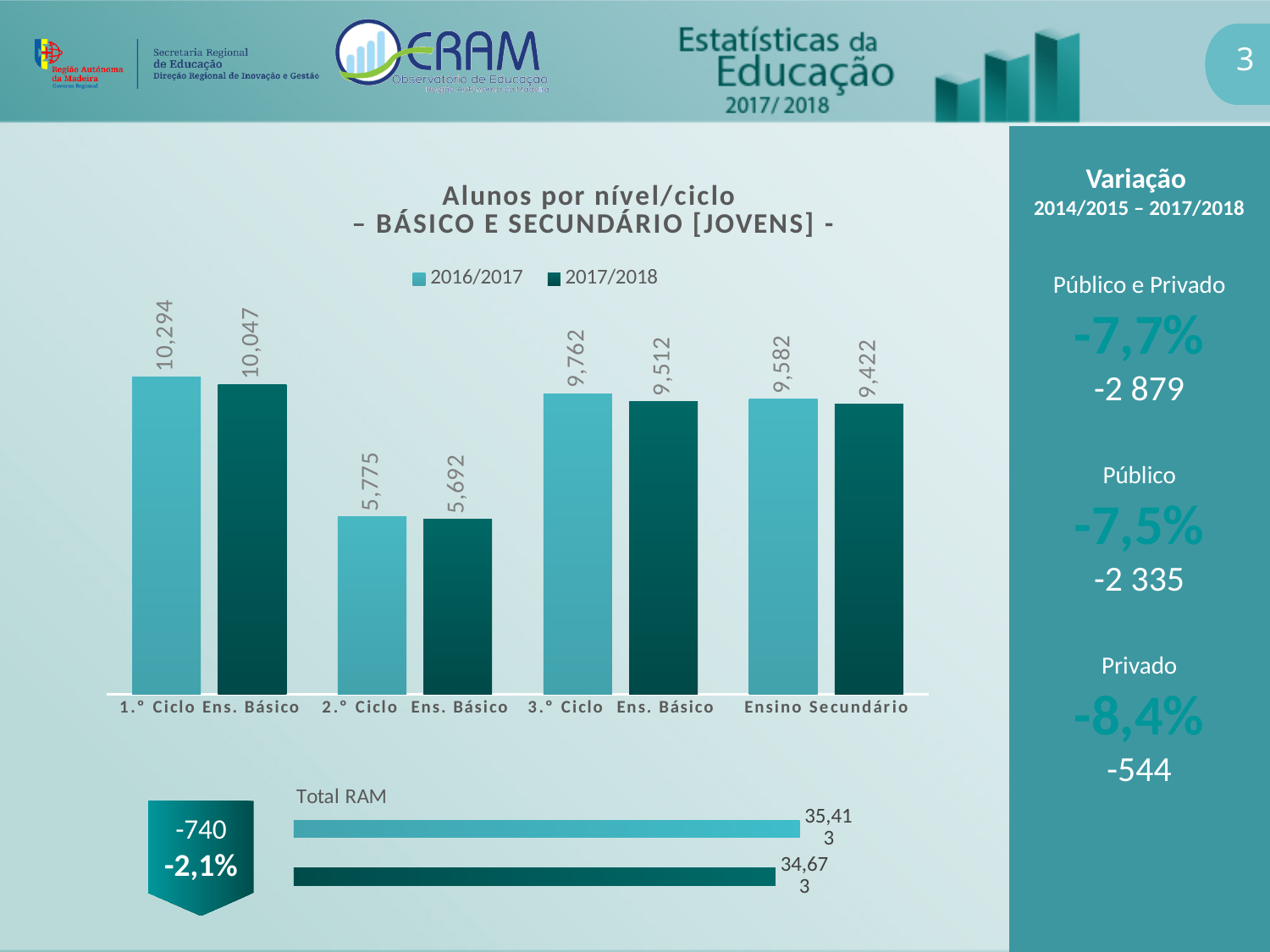
In the 'Total RAM' chart at the bottom of the slide, what is the value of the lighter (2016/2017) bar? 35,413 What kind of chart is the 'Alunos por nível/ciclo' chart? Bar chart How many categories are shown on the x axis of the 'Alunos por nível/ciclo' chart? 4 In the 'Alunos por nível/ciclo' chart, which category has the lowest value in 2016/2017? 2.º Ciclo Ens. Básico In the 'Alunos por nível/ciclo' chart, what is the difference between the 2016/2017 and 2017/2018 values for 1.º Ciclo Ens. Básico? 247 In the 'Alunos por nível/ciclo' chart, which category has the highest value in 2017/2018? 1.º Ciclo Ens. Básico In the 'Alunos por nível/ciclo' chart, what is the value for 1.º Ciclo Ens. Básico in 2016/2017? 10,294 In the 'Alunos por nível/ciclo' chart, which is larger: the 2017/2018 value for 3.º Ciclo Ens. Básico or the 2017/2018 value for Ensino Secundário? 3.º Ciclo Ens. Básico How many series does the legend of the 'Alunos por nível/ciclo' chart list? 2 In the 'Alunos por nível/ciclo' chart, what is the value for 2.º Ciclo Ens. Básico in 2017/2018? 5,692 In the 'Alunos por nível/ciclo' chart, what is the value for Ensino Secundário in 2017/2018? 9,422 In the 'Alunos por nível/ciclo' chart, what is the difference between the 2016/2017 and 2017/2018 values for 3.º Ciclo Ens. Básico? 250